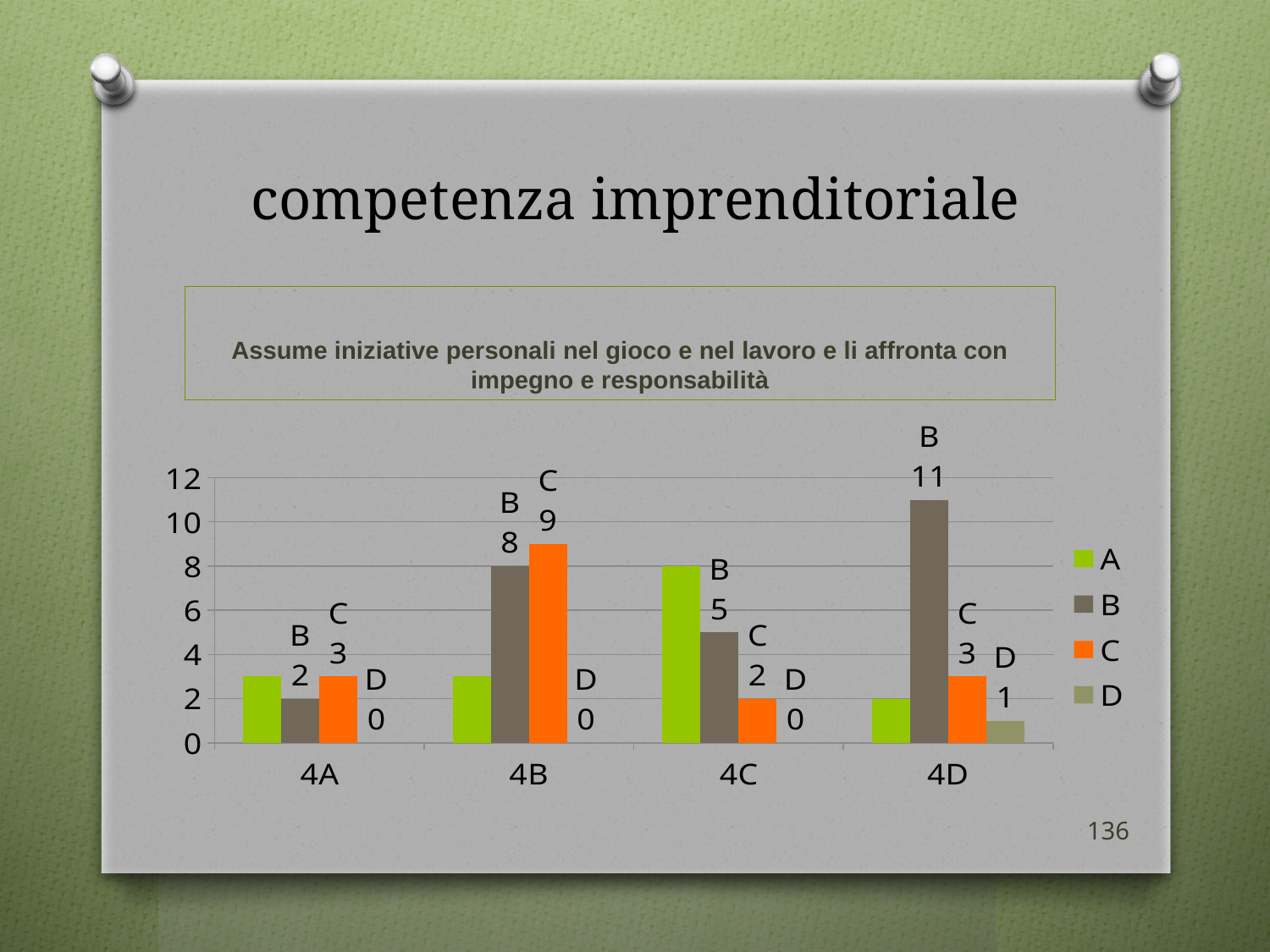
How many series does the legend list? 4 What is the difference between the series B values for 4D and 4B? 3 What kind of chart is shown on the slide? bar chart What is the value of series D for category 4D? 1 How many categories are shown on the x axis? 4 Is the value of series A for category 4C greater or less than 6? greater What is the value of series C for category 4B? 9 Which category has the lowest value for series B? 4A Which category has the highest value for series B? 4D What is the value of series B for category 4C? 5 What is the value of series B for category 4D? 11 Which is larger for category 4B: series B or series C? C